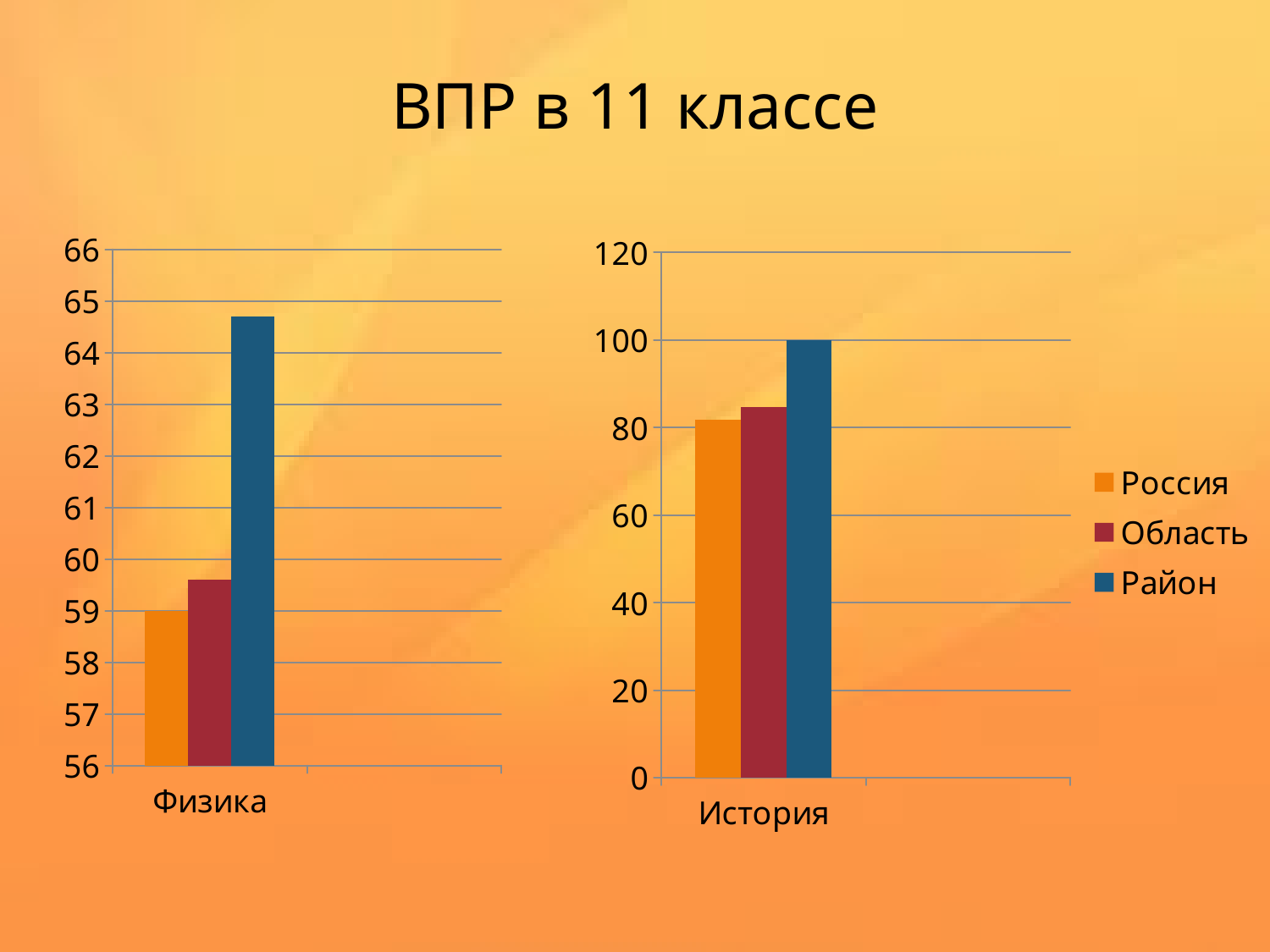
In the right chart (История), which series has the lowest value? Россия How many series does the legend list? 3 In the left chart (Физика), which is larger, the value for Область or the value for Район? Район In the left chart (Физика), is the value for Район greater or less than 64? greater In the left chart (Физика), which series has the highest value? Район In the right chart (История), which series has the highest value? Район In the right chart (История), what is the value for Район? 100 In the left chart (Физика), is the value for Область greater or less than 60? less In the left chart (Физика), which series has the lowest value? Россия What kind of chart is the right chart (История)? bar chart In the right chart (История), is the value for Область greater or less than 100? less